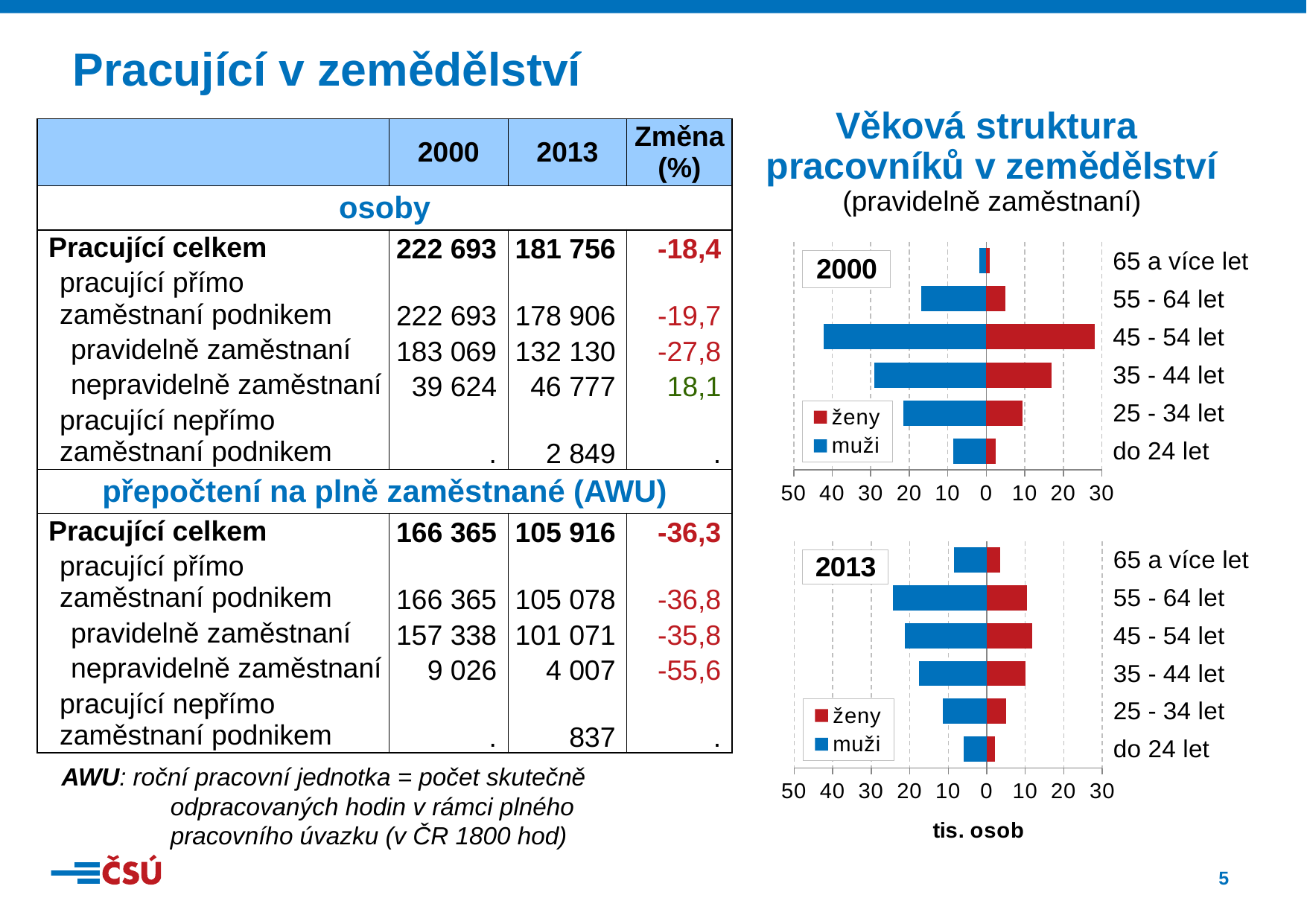
How many age groups are shown in the 2013 chart? 6 How many series does the legend of the 2000 chart list? 2 In the 2013 chart, is the value for women (ženy) aged 25 - 34 let greater or less than 10? less In the 2000 chart, is the value for men (muži) aged 55 - 64 let greater or less than 20? less What unit is shown on the horizontal axis of the 2013 chart? tis. osob In the 2013 chart, is the value for men (muži) aged 55 - 64 let greater or less than 20? greater In the 2013 chart, which age group has the smallest number of men (muži)? do 24 let In the 2000 chart, which age group has the smallest number of women (ženy)? 65 a více let In the 2000 chart, which is larger for men (muži): the 35 - 44 let group or the 25 - 34 let group? 35 - 44 let What kind of chart is the 2000 chart on the right side of the slide? bar chart In the 2000 chart, which age group has the largest number of men (muži)? 45 - 54 let